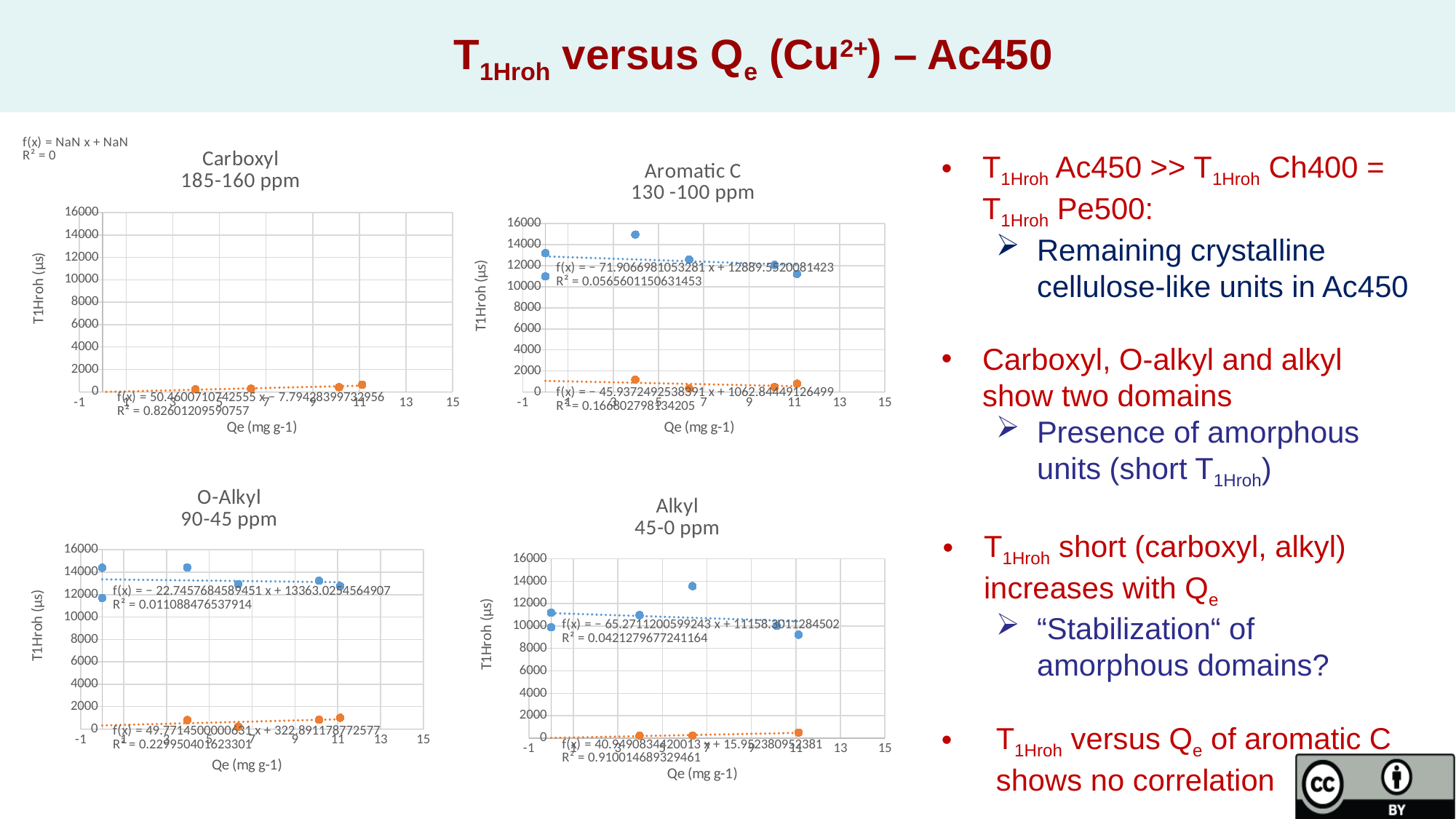
What is the y-axis title of the 'Alkyl 45-0 ppm' chart? T1Hroh (µs) In the 'Alkyl 45-0 ppm' chart, which series has the higher T1Hroh values, the blue series or the orange series? blue series What R² value is printed for the orange trendline in the 'Alkyl 45-0 ppm' chart? 0.910014689329461 In the 'Aromatic C 130 -100 ppm' chart, does the blue trendline rise or fall as Qe increases? fall In the 'Carboxyl 185-160 ppm' chart, are the orange points greater or less than 2000? less How many charts are shown on the slide? 4 In the 'O-Alkyl 90-45 ppm' chart, are the blue points greater or less than 10000? greater In the 'Carboxyl 185-160 ppm' chart, does the orange trendline rise or fall as Qe increases? rise What kind of chart is the 'Aromatic C 130 -100 ppm' chart? scatter chart In the 'O-Alkyl 90-45 ppm' chart, are the orange points greater or less than 2000? less